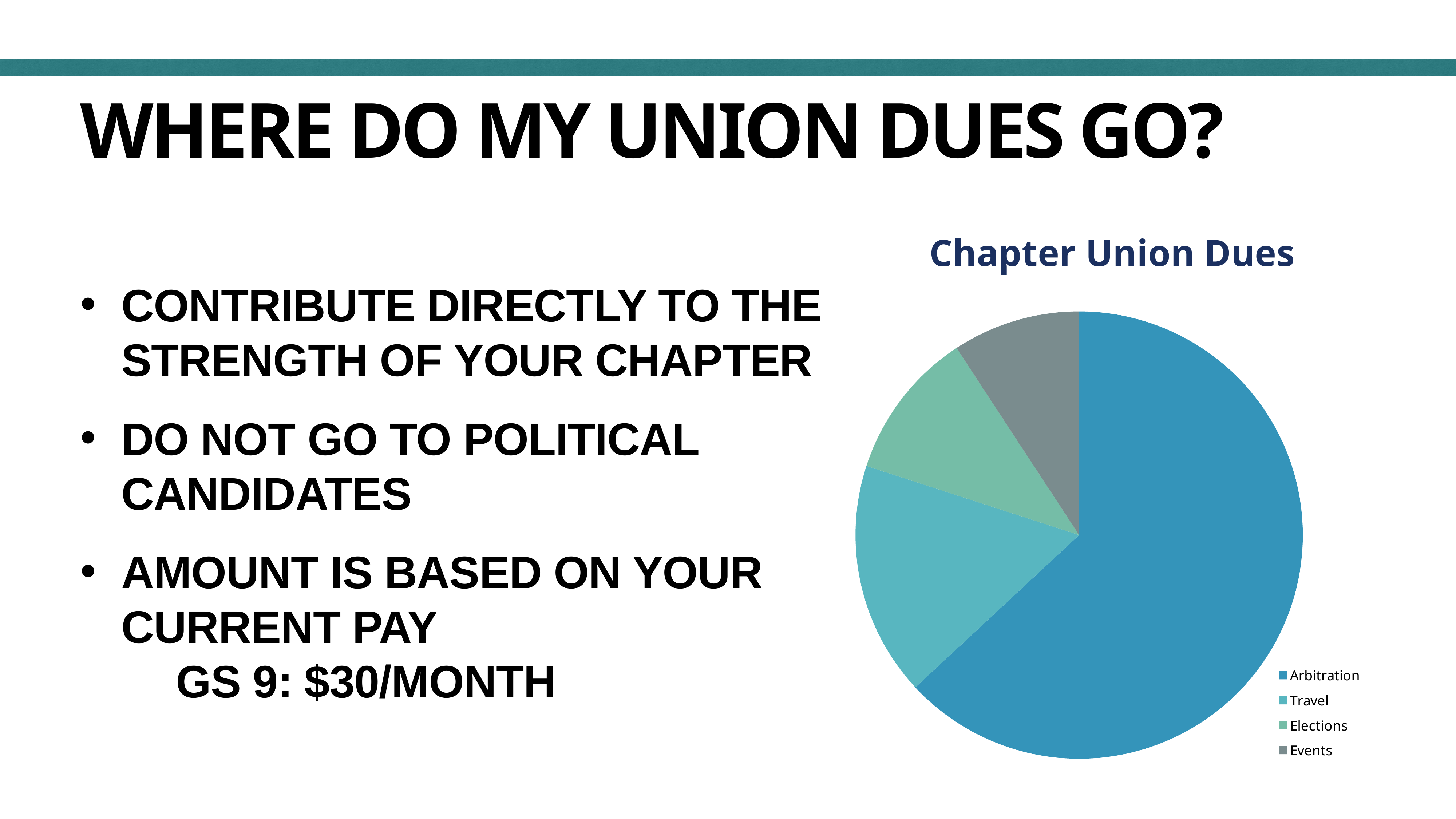
How many slices does the Chapter Union Dues pie chart have? 4 Which is larger in the Chapter Union Dues chart, Arbitration or Elections? Arbitration Which is larger in the Chapter Union Dues chart, Arbitration or Travel? Arbitration Does Arbitration account for more or less than half of the Chapter Union Dues pie? More Which category is listed last in the legend of the Chapter Union Dues chart? Events How many entries does the legend of the Chapter Union Dues chart list? 4 What is the title of the chart? Chapter Union Dues What kind of chart is shown on the slide? Pie chart Which category takes the largest share of the Chapter Union Dues pie chart? Arbitration